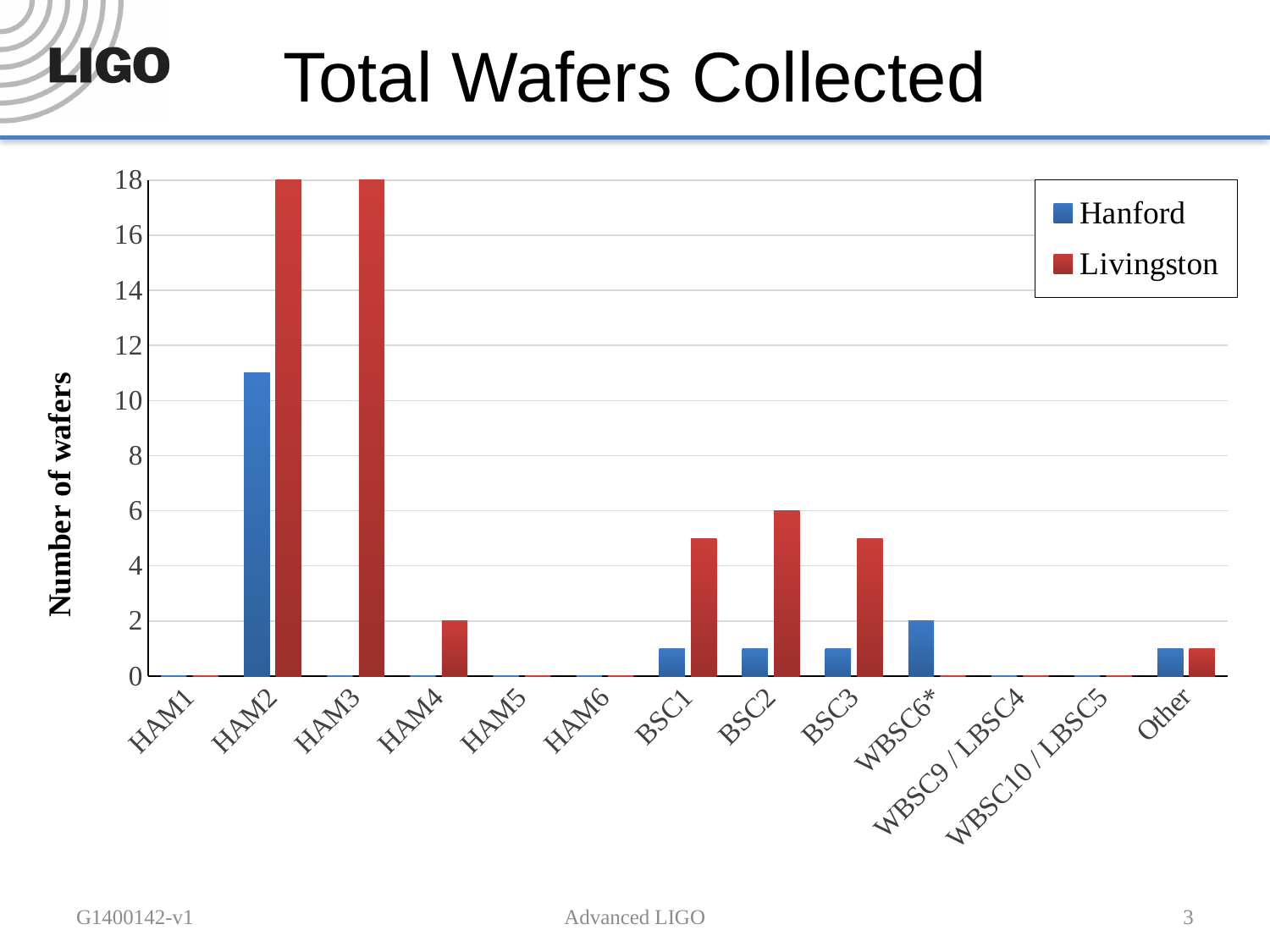
What is the difference between the Livingston values for HAM3 and HAM4? 16 What is the Livingston value for HAM2? 18 What type of chart is shown on the slide? bar chart What is the Hanford value for WBSC6*? 2 How many categories are shown on the x axis? 13 For HAM2, which series has the larger value, Hanford or Livingston? Livingston How many series does the legend list? 2 What is the Livingston value for HAM3? 18 What is the Livingston value for HAM4? 2 Is the Hanford value for HAM2 greater or less than 10? greater Which category has the highest Hanford value? HAM2 What is the Livingston value for BSC2? 6